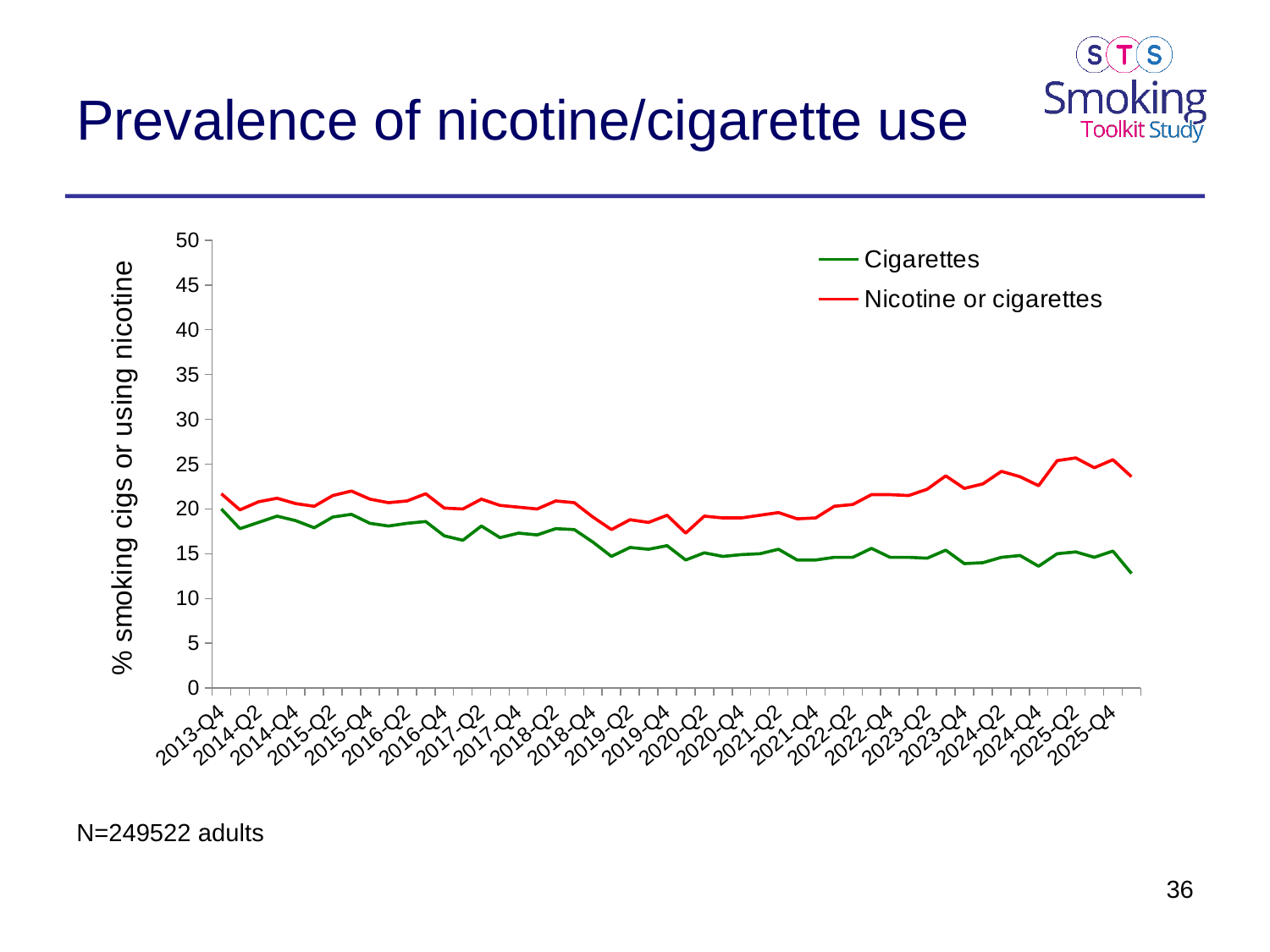
What are the two series named in the legend? Cigarettes; Nicotine or cigarettes Does the Nicotine or cigarettes series rise or fall overall from 2020-Q2 to 2025-Q2? Rise Which series has the higher values across the whole period, Cigarettes or Nicotine or cigarettes? Nicotine or cigarettes Is the value for Nicotine or cigarettes at 2020-Q2 greater or less than 20? less Is the value for Nicotine or cigarettes at 2023-Q4 greater or less than 20? greater Is the value for Cigarettes at 2016-Q2 greater or less than 15? greater Which series reaches the highest value on the chart? Nicotine or cigarettes How many series does the legend list? 2 Does the Cigarettes series rise or fall overall from 2013-Q4 to 2025-Q4? Fall What is the label on the vertical axis? % smoking cigs or using nicotine What kind of chart is shown on the slide? Line chart